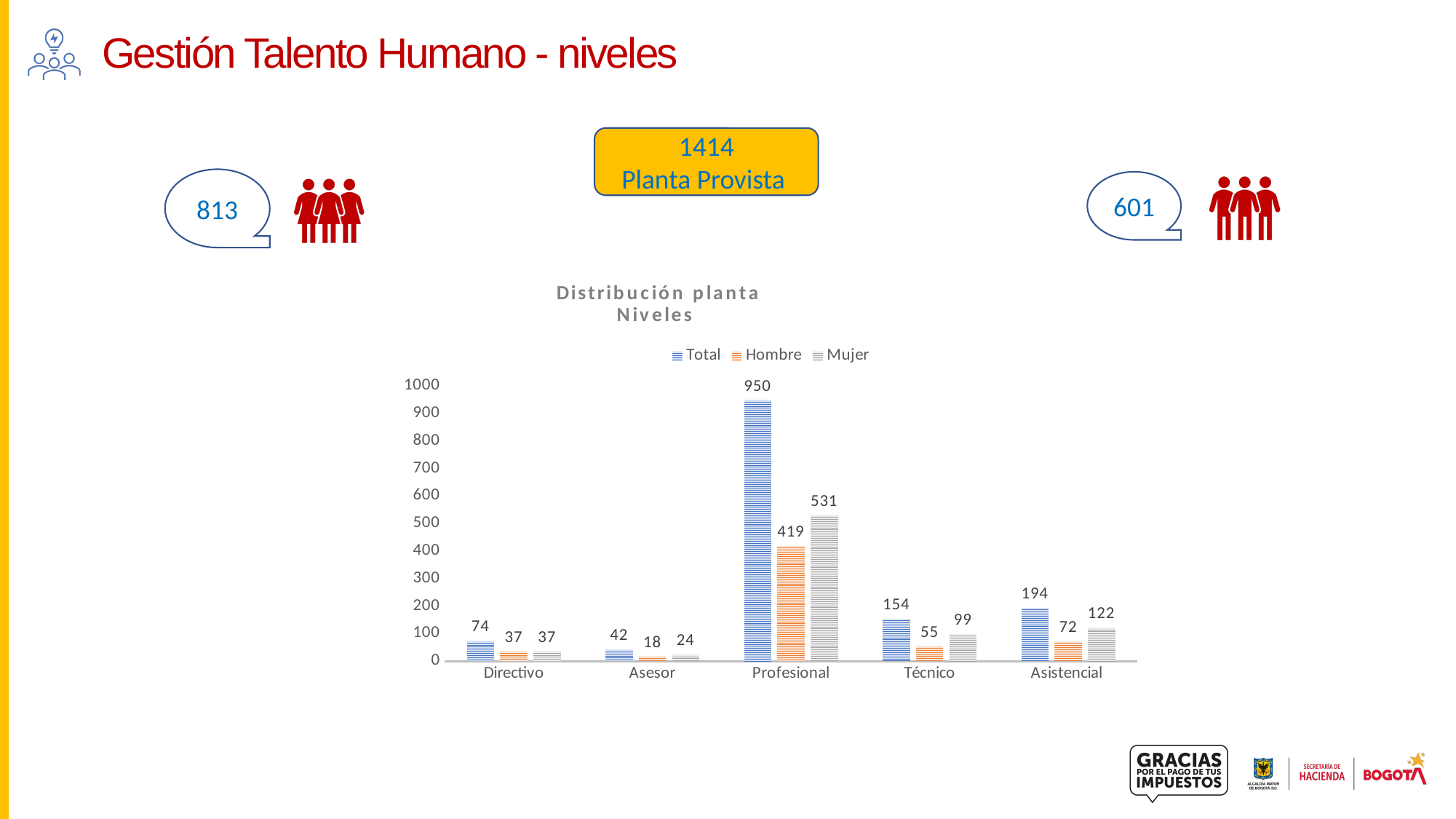
What is the Hombre value for Asesor? 18 What is the Mujer value for Asistencial? 122 Which category has the lowest Total value? Asesor What is the Total value for Profesional? 950 How many series does the legend list? 3 Which is larger for Técnico, the Hombre value or the Mujer value? Mujer What is the title of the chart? Distribución planta Niveles What kind of chart is shown? bar chart Which category has the highest Total value? Profesional What is the difference between the Mujer and Hombre values for Profesional? 112 How many categories are shown on the x axis? 5 Is the Total value for Asistencial greater or less than 100? greater